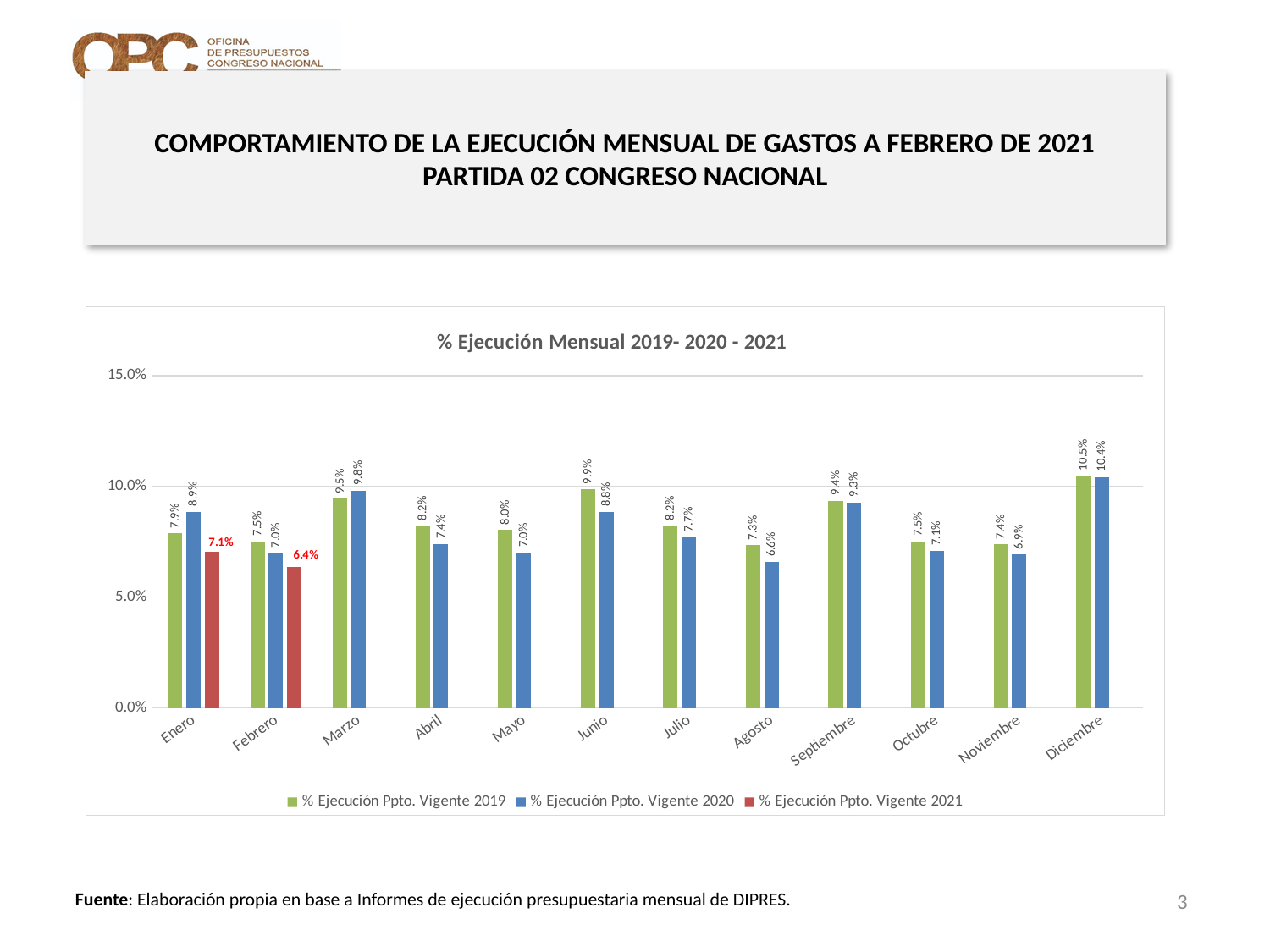
What is the value for Enero in the % Ejecución Ppto. Vigente 2021 series? 7.1% What type of chart is shown on the slide? Bar chart How many months are shown on the x axis? 12 Which month has the lowest value in the % Ejecución Ppto. Vigente 2020 series? Agosto Is the value for Diciembre in the 2019 series greater or less than 10.0%? greater What is the value for Febrero in the % Ejecución Ppto. Vigente 2021 series? 6.4% Which month has the highest value in the % Ejecución Ppto. Vigente 2019 series? Diciembre What is the title of the chart? % Ejecución Mensual 2019- 2020 - 2021 Which is larger for Junio: the 2019 value or the 2020 value? 2019 value (9.9%) What is the value for Marzo in the % Ejecución Ppto. Vigente 2020 series? 9.8% How many series does the legend list? 3 What is the difference between the 2019 and 2020 values for Enero? 1.0%